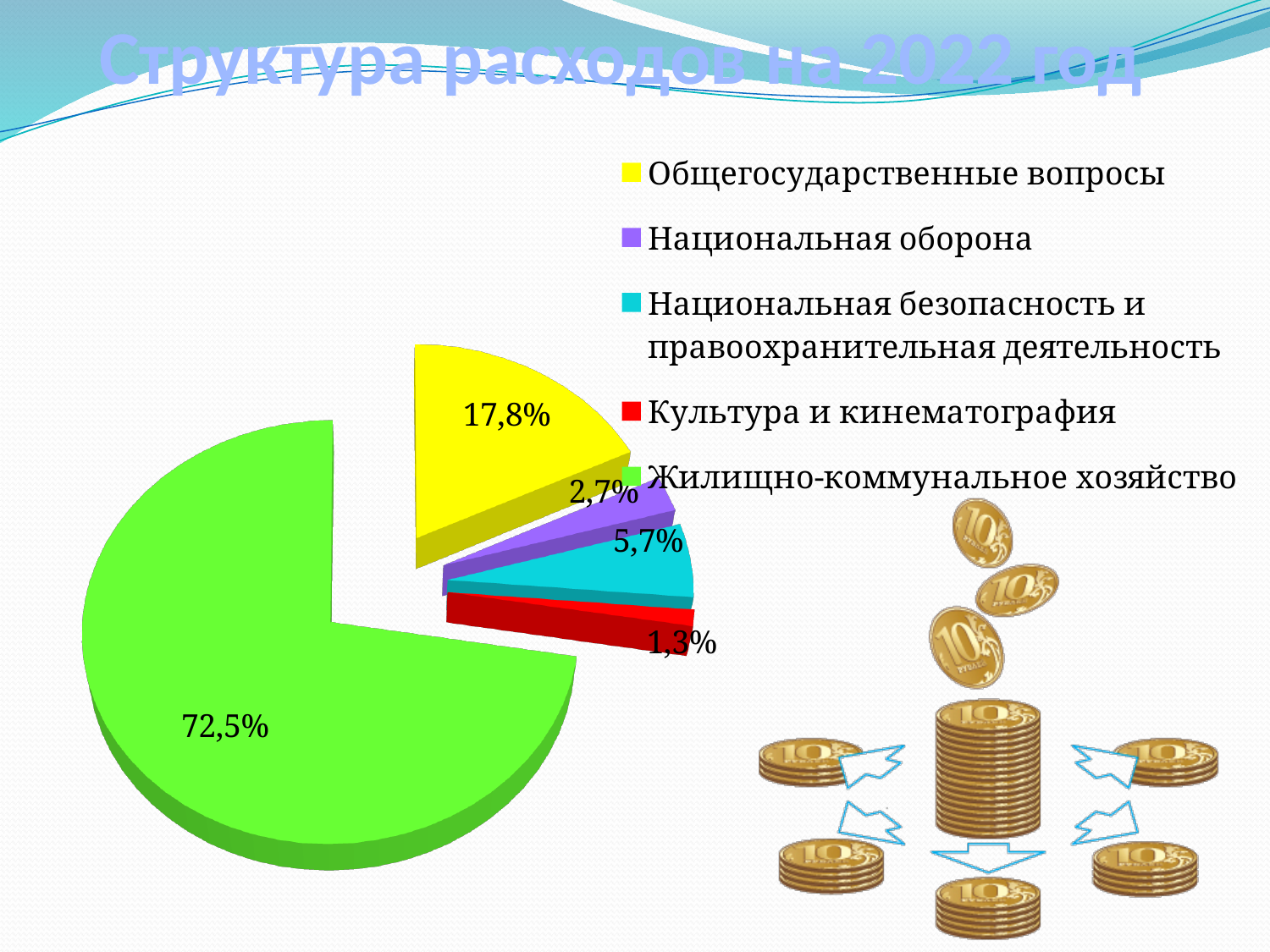
Какова доля расходов на жилищно-коммунальное хозяйство? 72,5% Какая категория расходов имеет наименьшую долю? Культура и кинематография Какой тип диаграммы показан на слайде? Круговая диаграмма Что больше: доля национальной безопасности и правоохранительной деятельности или доля национальной обороны? Национальная безопасность и правоохранительная деятельность Каким цветом на диаграмме обозначены общегосударственные вопросы? Жёлтым На сколько процентных пунктов доля общегосударственных вопросов больше доли национальной обороны? 15,1 Какова доля расходов на общегосударственные вопросы? 17,8% Сколько категорий расходов показано на диаграмме? 5 Какова доля расходов на культуру и кинематографию? 1,3% Какова доля расходов на национальную оборону? 2,7% Какая категория расходов имеет наибольшую долю? Жилищно-коммунальное хозяйство Какова доля расходов на национальную безопасность и правоохранительную деятельность? 5,7%